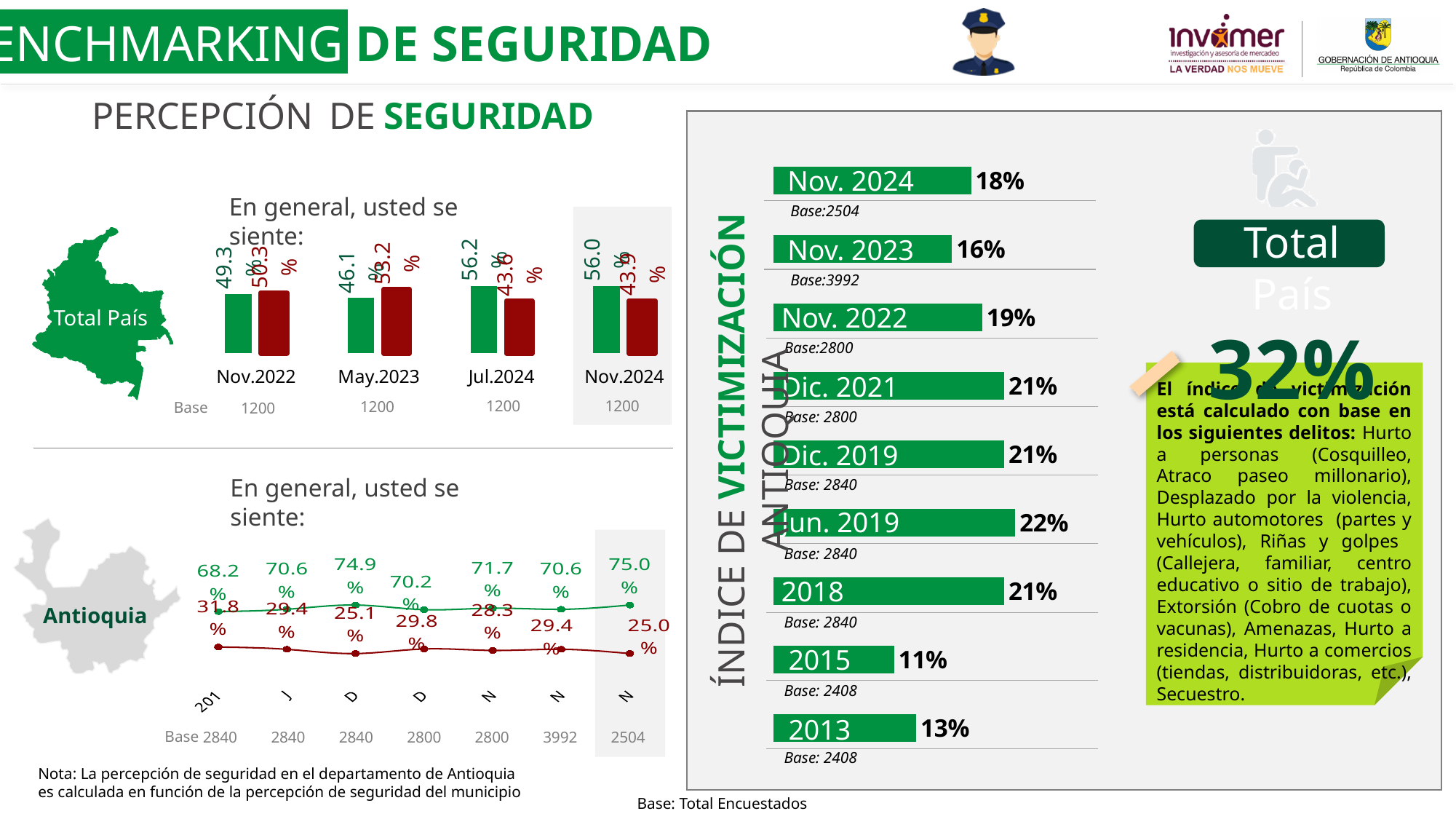
In the Total País 'En general, usted se siente' bar chart, what is the red bar value for May.2023? 53.2% In the Total País 'En general, usted se siente' bar chart, what is the green bar value for Nov.2024? 56.0% In the Índice de Victimización Antioquia chart, which period has the lowest value? 2015 In the Antioquia 'En general, usted se siente' line chart, what is the green line value at the rightmost (highlighted) point? 75.0% What kind of chart is the Índice de Victimización Antioquia chart? Bar chart In the Índice de Victimización Antioquia chart, what is the value for Nov. 2024? 18% In the Índice de Victimización Antioquia chart, how many periods are shown? 9 In the Antioquia 'En general, usted se siente' line chart, how many data points does each line have? 7 In the Índice de Victimización Antioquia chart, which period has the highest value? Jun. 2019 In the Índice de Victimización Antioquia chart, what is the difference between Nov. 2024 and Nov. 2023? 2 percentage points In the Índice de Victimización Antioquia chart, which is larger: Nov. 2022 or 2013? Nov. 2022 In the Total País 'En general, usted se siente' bar chart, how many time periods are shown? 4